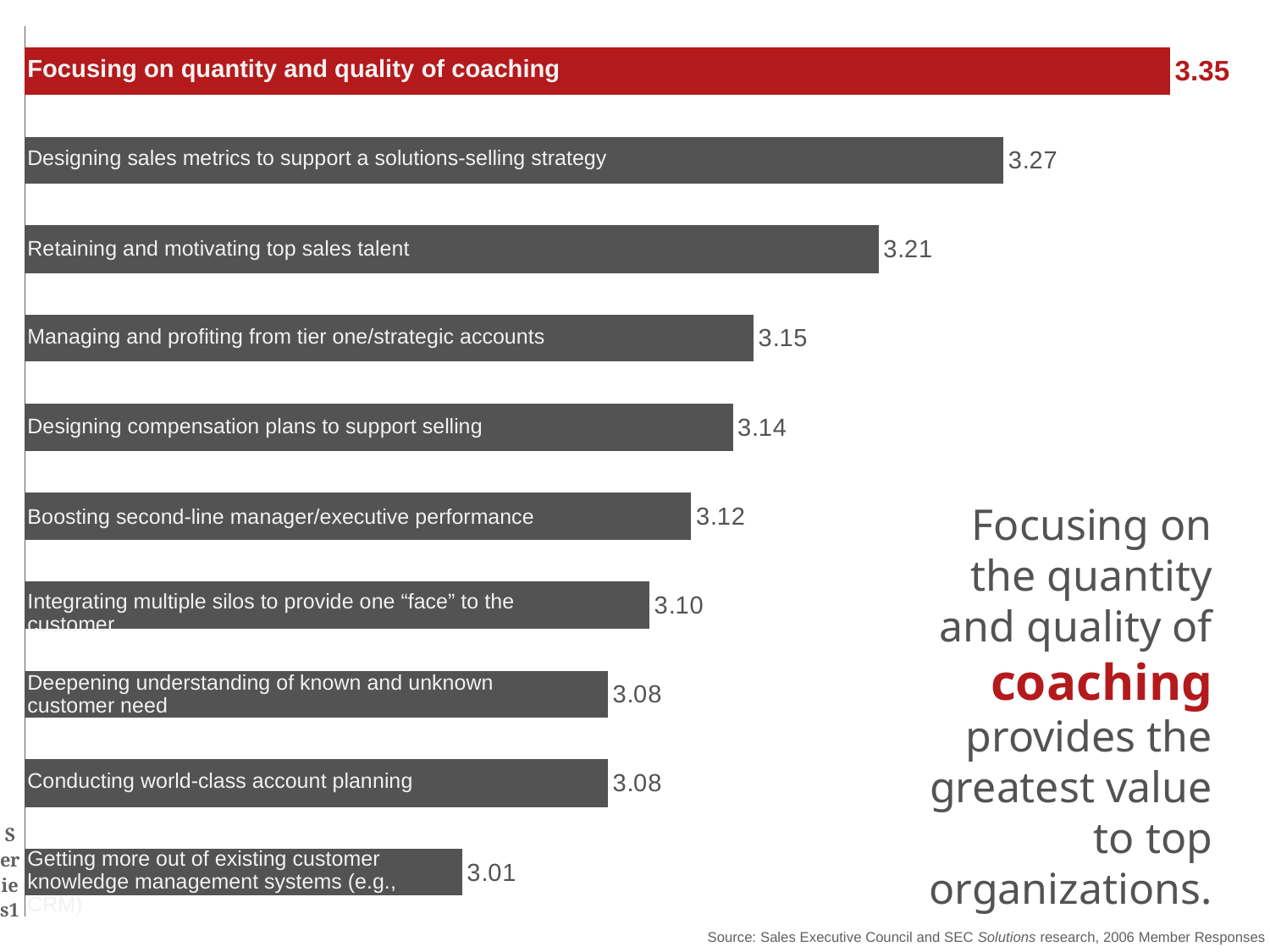
What is the value for "Focusing on quantity and quality of coaching"? 3.35 Which category has the highest value? Focusing on quantity and quality of coaching What kind of chart is shown on the slide? Bar chart Which category has the lowest value? Getting more out of existing customer knowledge management systems (e.g., CRM) What is the value for "Getting more out of existing customer knowledge management systems (e.g., CRM)"? 3.01 Which bar is coloured red rather than grey? Focusing on quantity and quality of coaching What is the value for "Designing compensation plans to support selling"? 3.14 What is the difference between the values for "Focusing on quantity and quality of coaching" and "Designing sales metrics to support a solutions-selling strategy"? 0.08 What is the difference between the highest and lowest values in the chart? 0.34 What is the value for "Retaining and motivating top sales talent"? 3.21 How many categories are shown in the chart? 10 Which has a larger value: "Retaining and motivating top sales talent" or "Managing and profiting from tier one/strategic accounts"? Retaining and motivating top sales talent